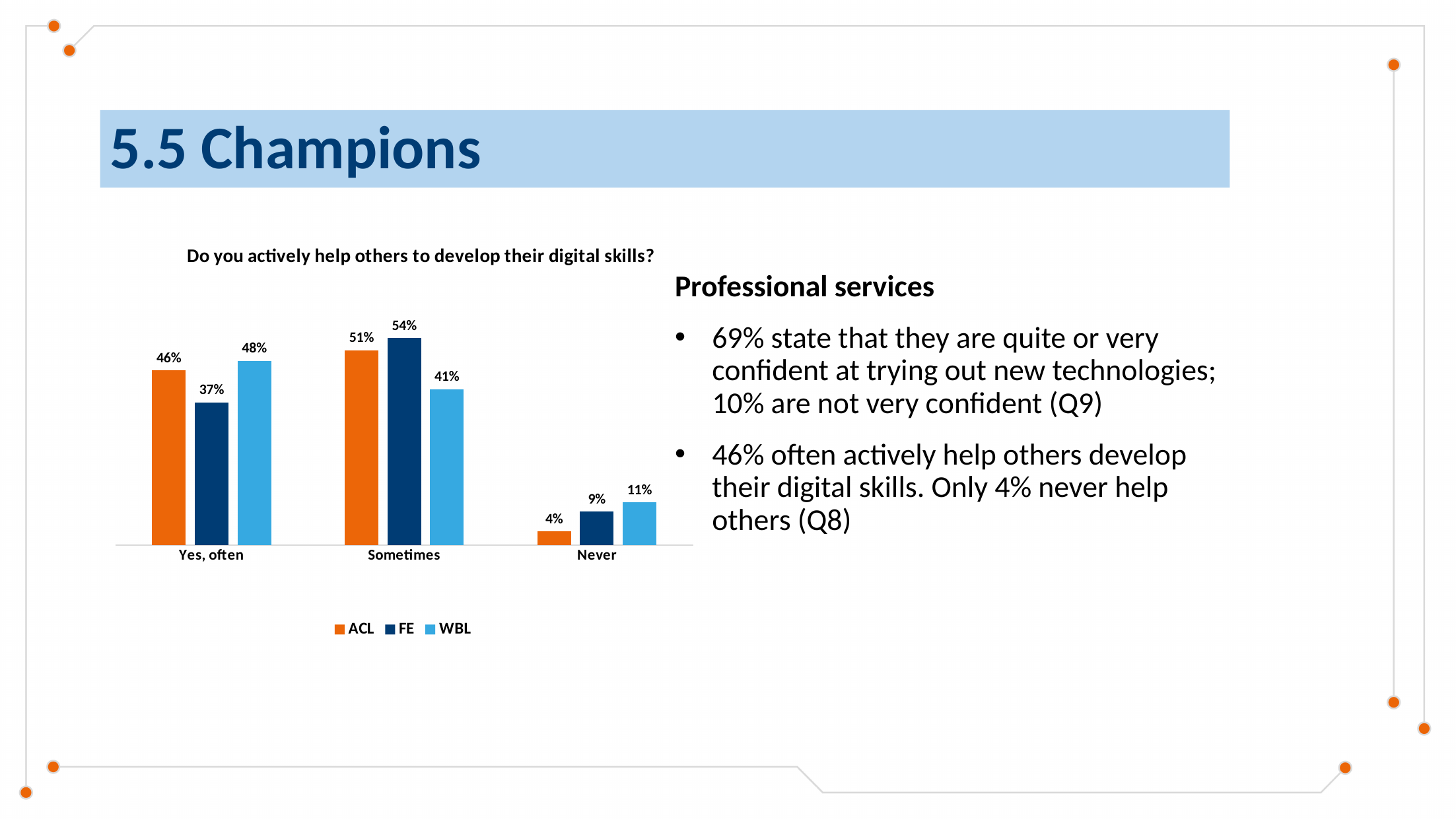
What is the difference between the WBL and FE values in the "Yes, often" category? 11% Which series is shown in orange in the legend? ACL What is the value for WBL in the "Never" category? 11% Which is larger in the "Sometimes" category, the ACL value or the WBL value? ACL What is the value for FE in the "Sometimes" category? 54% How many series does the legend list? 3 Which series has the lowest value in the "Never" category? ACL How many categories are shown on the x axis? 3 What kind of chart is shown on the slide? Bar chart What is the value for ACL in the "Yes, often" category? 46% What is the title of the chart? Do you actively help others to develop their digital skills? Which series has the highest value in the "Sometimes" category? FE